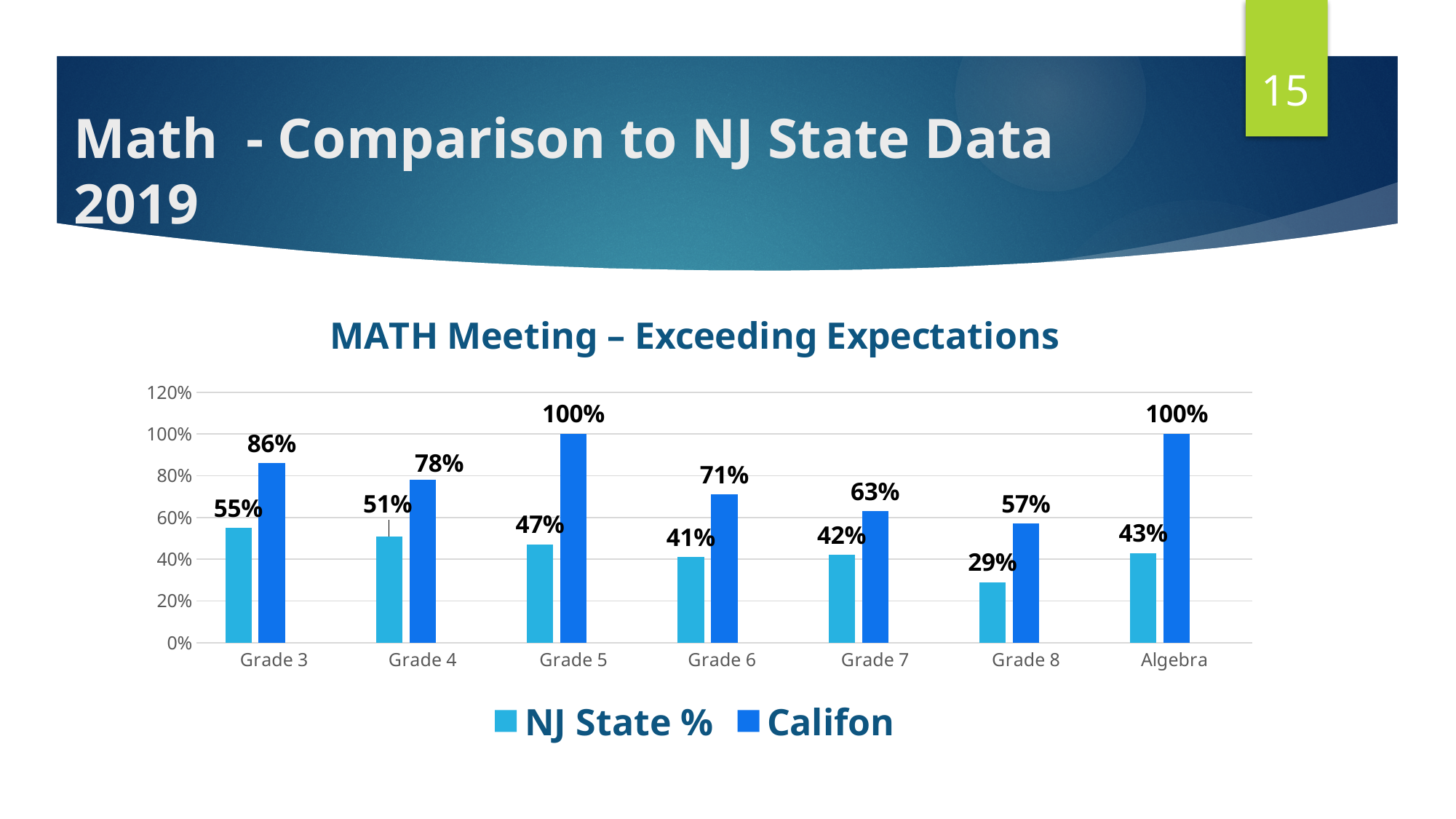
What is the difference between the Califon and NJ State % values for Grade 8? 28% What is the Califon value for Grade 5? 100% How many series does the legend list? 2 Which is larger for Grade 7: the NJ State % value or the Califon value? Califon What is the Califon value for Grade 6? 71% How many categories are shown on the x axis? 7 What kind of chart is shown on the slide? Bar chart What is the difference between the Califon and NJ State % values for Grade 3? 31% What is the NJ State % value for Grade 8? 29% Which category has the highest NJ State % value? Grade 3 What is the title of the chart? MATH Meeting – Exceeding Expectations Which category has the lowest NJ State % value? Grade 8